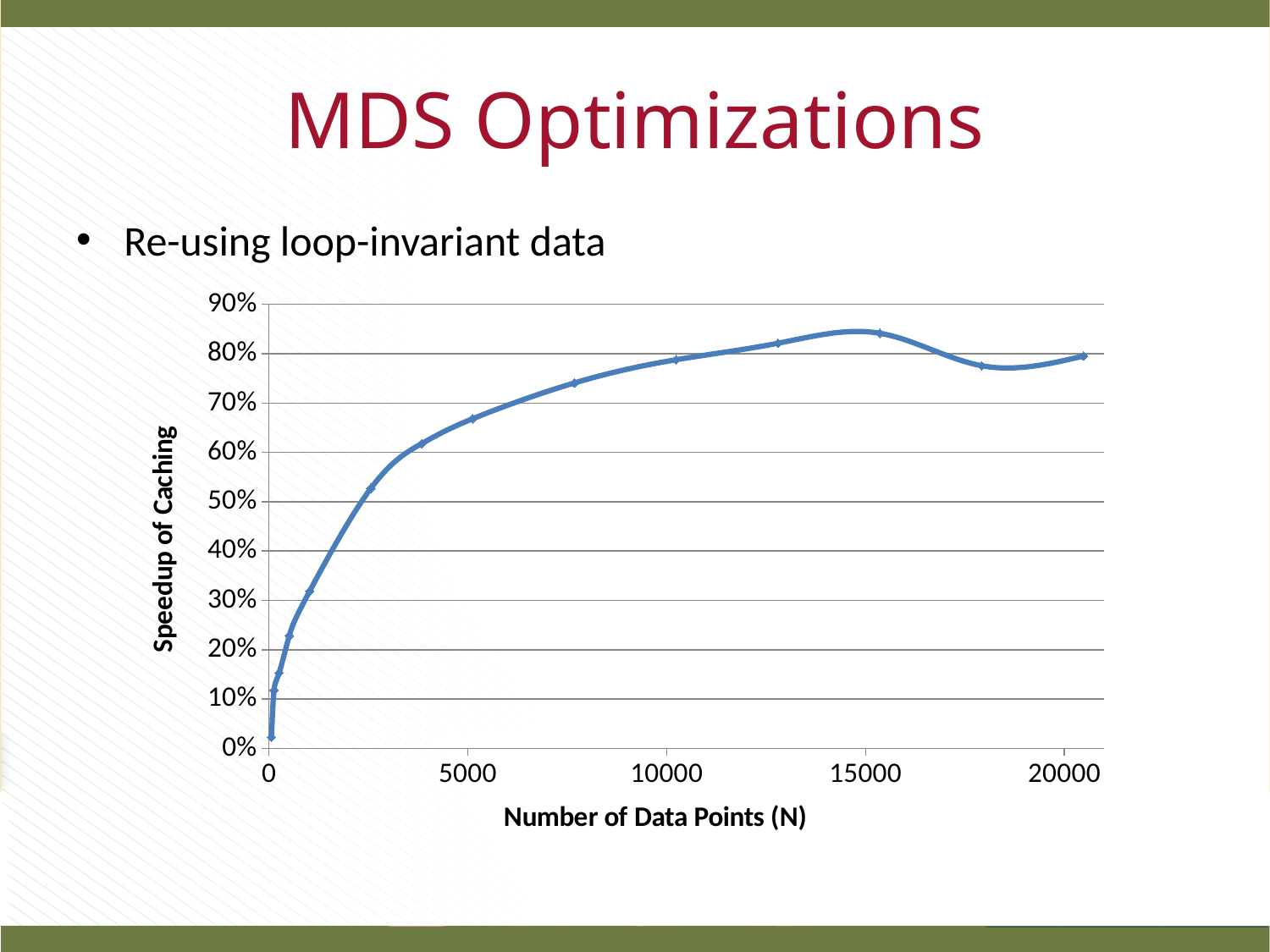
Is the speedup of caching at about 2500 data points greater or less than 40%? greater Is the speedup of caching at about 10000 data points greater or less than 70%? greater Is the speedup of caching at about 20000 data points greater or less than 70%? greater What is the title of the y axis of the chart? Speedup of Caching Does the speedup of caching generally rise or fall as the number of data points increases from 0 to 15000? rise Which is larger, the speedup of caching at about 15000 data points or at about 5000 data points? at about 15000 data points What is the title of the x axis of the chart? Number of Data Points (N) What kind of chart is shown on the slide? line chart